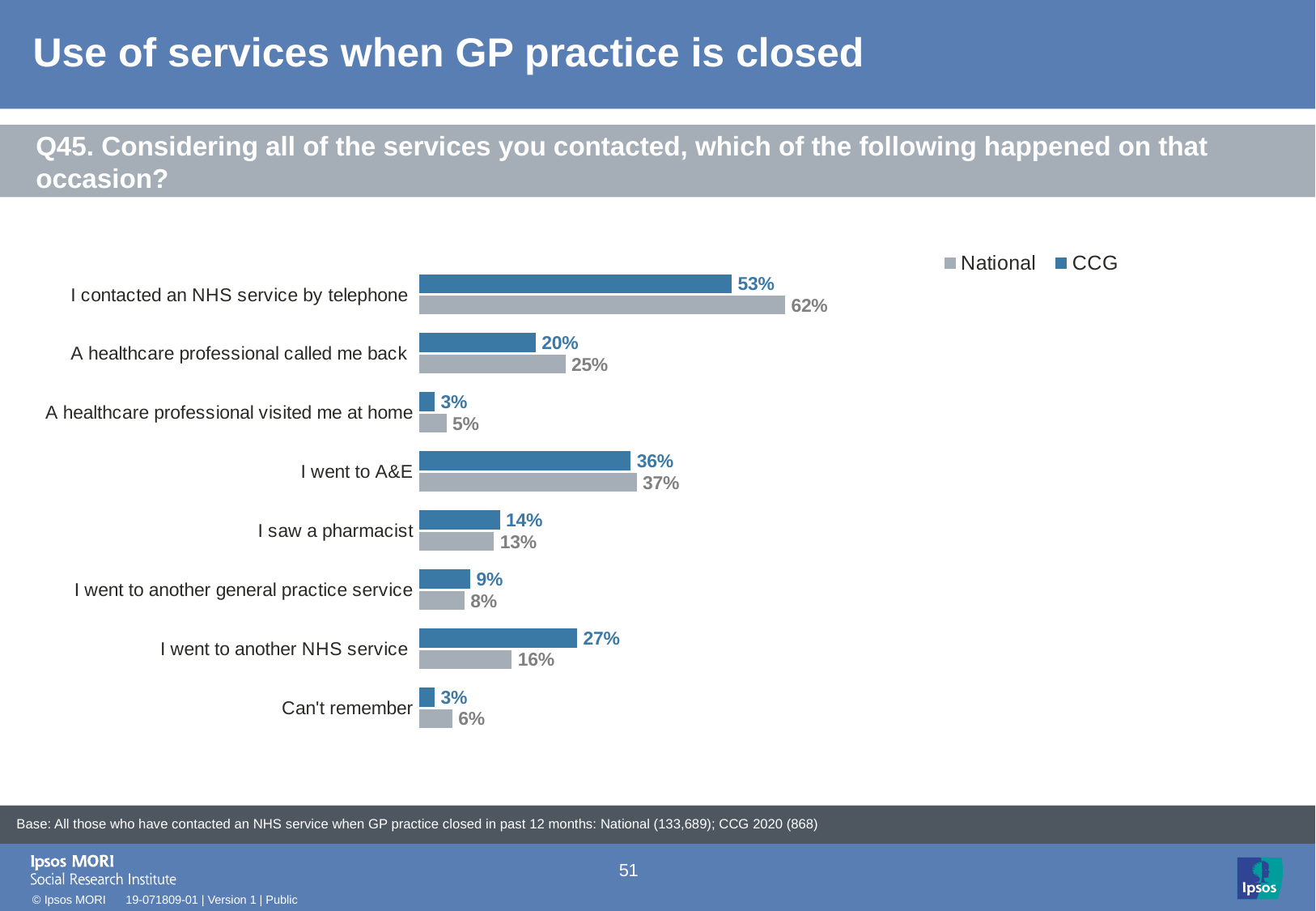
For 'Can't remember', which is larger, the CCG value or the National value? National What is the difference between the National and CCG values for 'I contacted an NHS service by telephone'? 9% What is the National value for 'I went to another NHS service'? 16% What is the CCG value for 'I contacted an NHS service by telephone'? 53% For 'I saw a pharmacist', which is larger, the CCG value or the National value? CCG Which category has the highest CCG value? I contacted an NHS service by telephone Which category has the lowest National value? A healthcare professional visited me at home How many series does the legend list? 2 What kind of chart is shown on the slide? Bar chart What is the difference between the CCG and National values for 'I went to another NHS service'? 11% How many categories are shown in the chart? 8 What is the National value for 'A healthcare professional called me back'? 25%